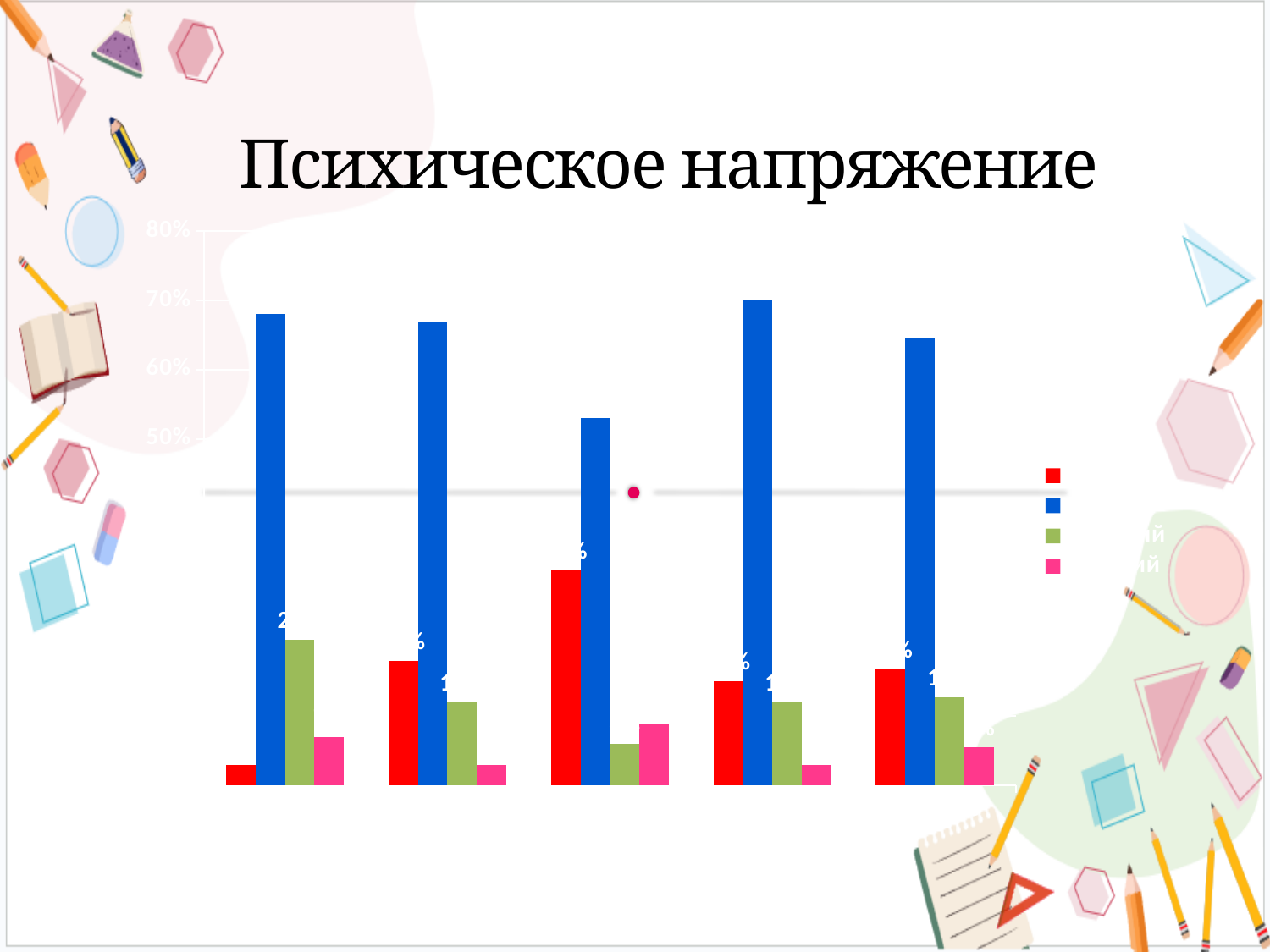
In the first group from the left, which is larger: the blue bar or the red bar? the blue bar What is the title of the chart? Психическое напряжение Among the blue bars, which group from the left has the lowest value? the third group Is the blue bar in the fourth group from the left greater or less than 60%? greater What kind of chart is shown on the slide? bar chart Among the blue bars, which group from the left has the highest value? the fourth group Is the blue bar in the third group from the left greater or less than 60%? less Is the blue bar in the first group from the left greater or less than 60%? greater How many series does the legend list? 4 Which is larger: the red bar in the third group or the red bar in the first group? the red bar in the third group Which colour is used for the tallest bar in every group? blue How many groups of bars are plotted along the x axis? 5